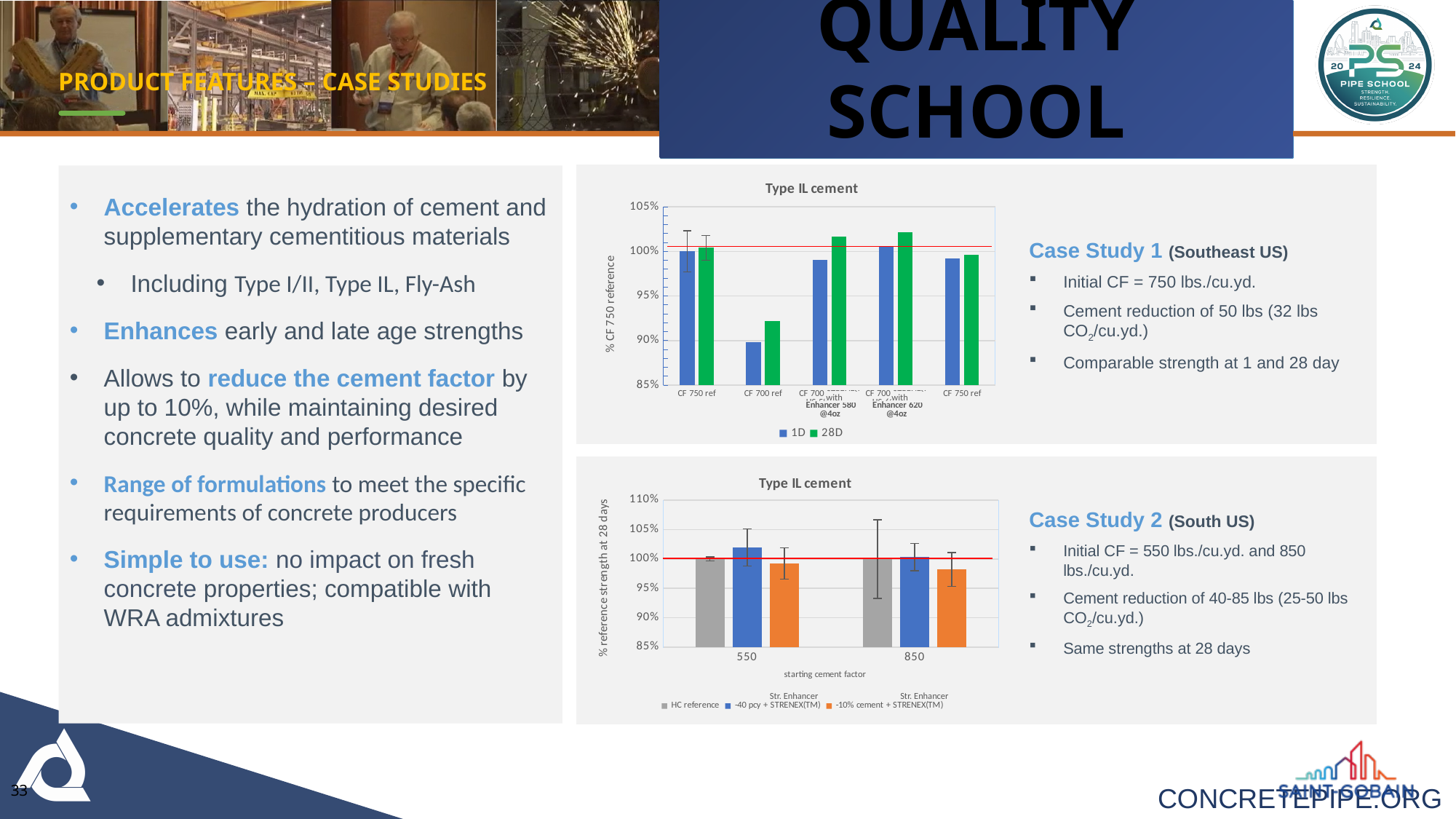
How many series does the legend of the top chart list? 2 How many categories are shown on the x axis of the bottom chart? 2 What kind of chart is the top chart on the slide? bar chart How many series does the legend of the bottom chart list? 3 What is the x-axis title of the bottom chart? starting cement factor What is the y-axis title of the top chart? % CF 750 reference In the top chart, which category has the lowest 1D value? CF 700 ref In the top chart, is the 28D value for CF 700 ref greater or less than 95%? less In the bottom chart, at starting cement factor 550, which is larger: -40 pcy + STRENEX(TM) or -10% cement + STRENEX(TM)? -40 pcy + STRENEX(TM) In the top chart, is the 1D value for CF 700 ref greater or less than 95%? less In the top chart, for CF 700 ref, which is larger: the 1D value or the 28D value? 28D How many categories are shown on the x axis of the top chart? 5